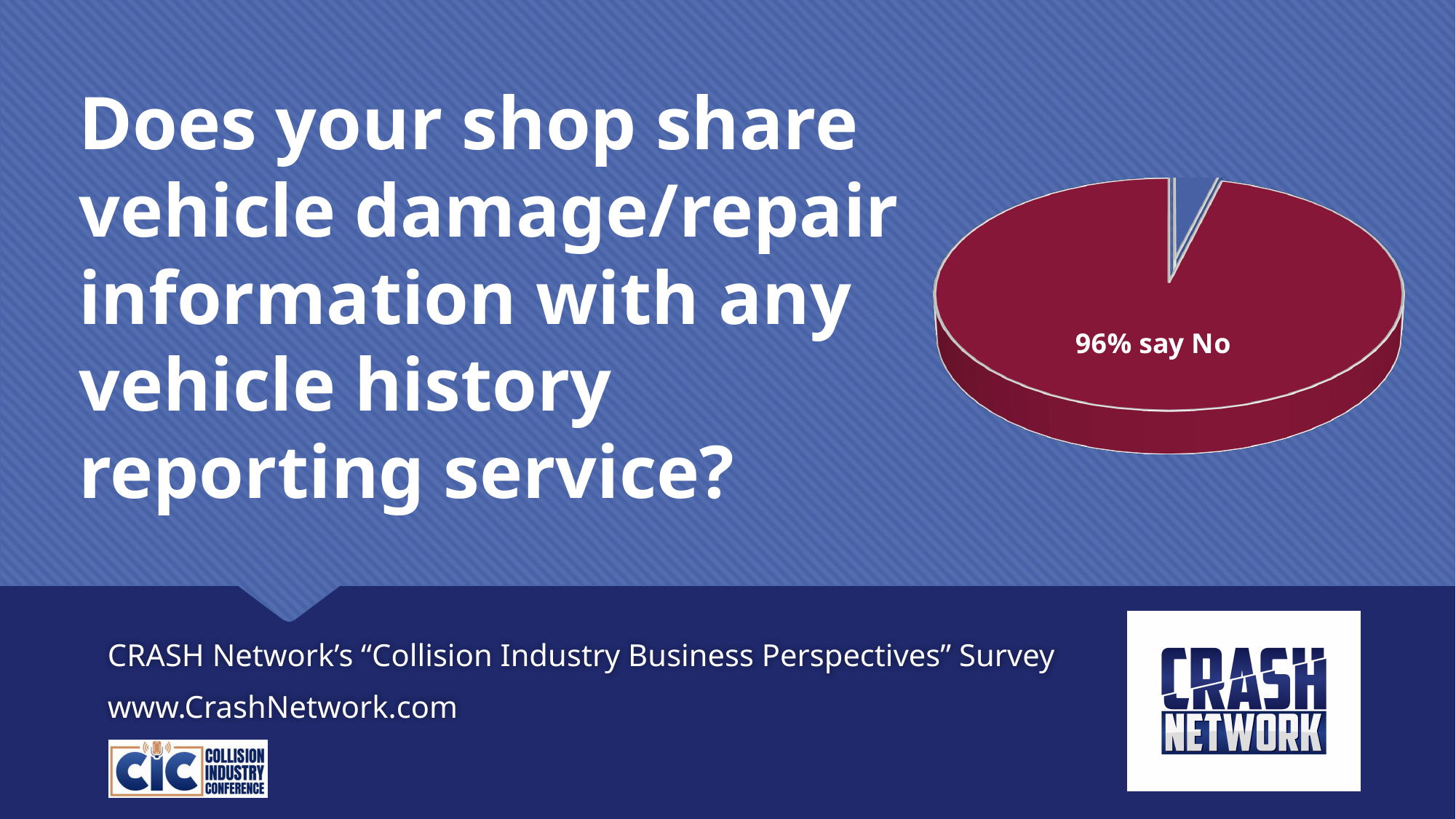
How many slices does the pie chart have? 2 What share of respondents say No according to the pie chart? 96% Which response makes up the largest slice of the pie chart? No Is the slice for respondents who say No larger or smaller than the other slice? larger What kind of chart is shown on the slide? pie chart What text label is printed on the pie chart? 96% say No What colour is the slice representing the respondents who say No? dark red